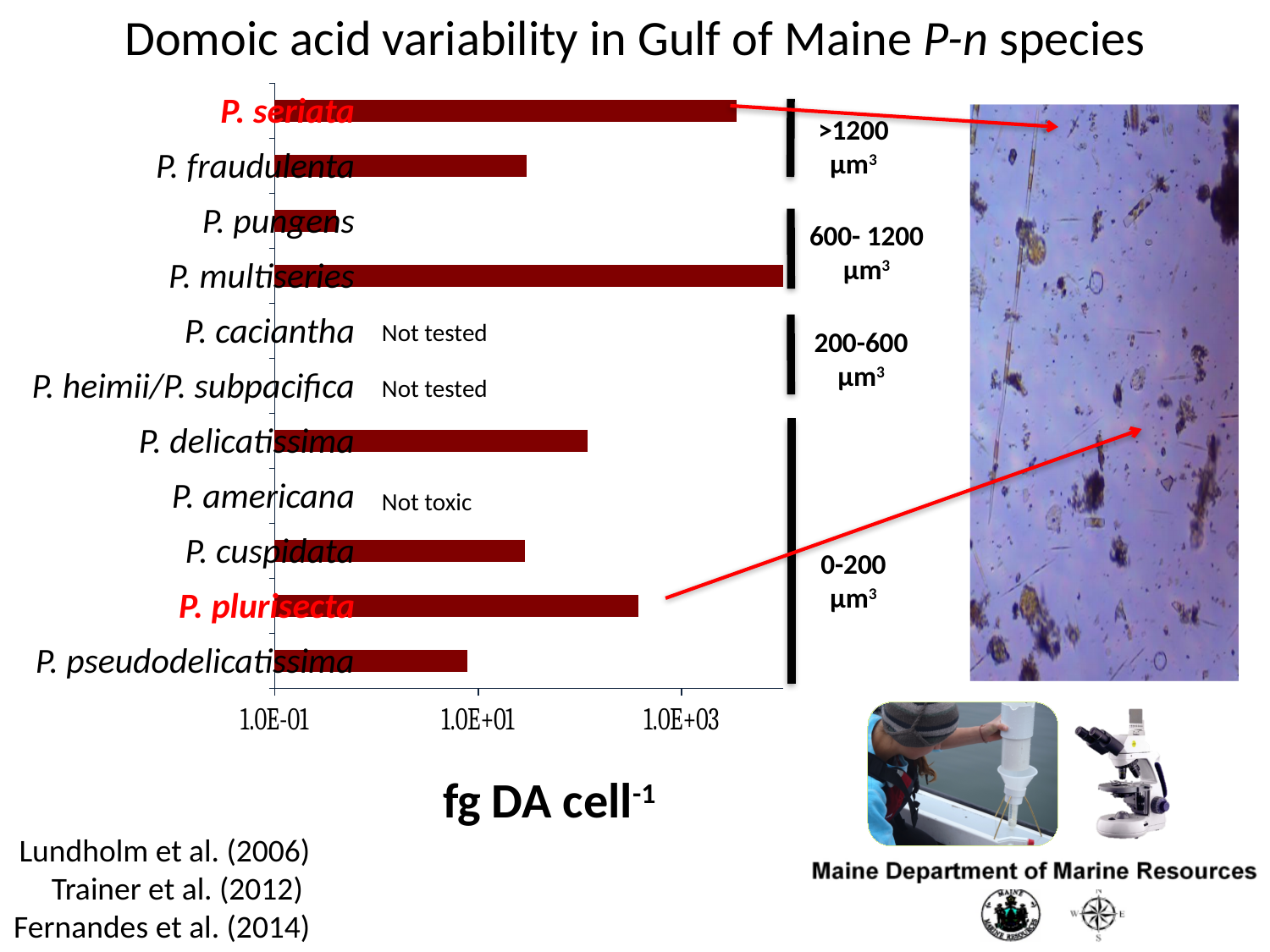
Which has the larger value, P. plurisecta or P. delicatissima? P. plurisecta Which species with a plotted bar has the shortest bar? P. pungens What is the label on the x axis of the chart? fg DA cell-1 Which has the larger value, P. seriata or P. fraudulenta? P. seriata What kind of chart is shown on the slide? bar chart Is the value for P. delicatissima greater or less than 1.0E+01? greater How many species are listed on the y axis of the chart? 11 Which species has the longest bar in the chart? P. multiseries Is the value for P. seriata greater or less than 1.0E+03? greater Is the value for P. plurisecta greater or less than 1.0E+03? less What is written in place of a bar for P. americana? Not toxic